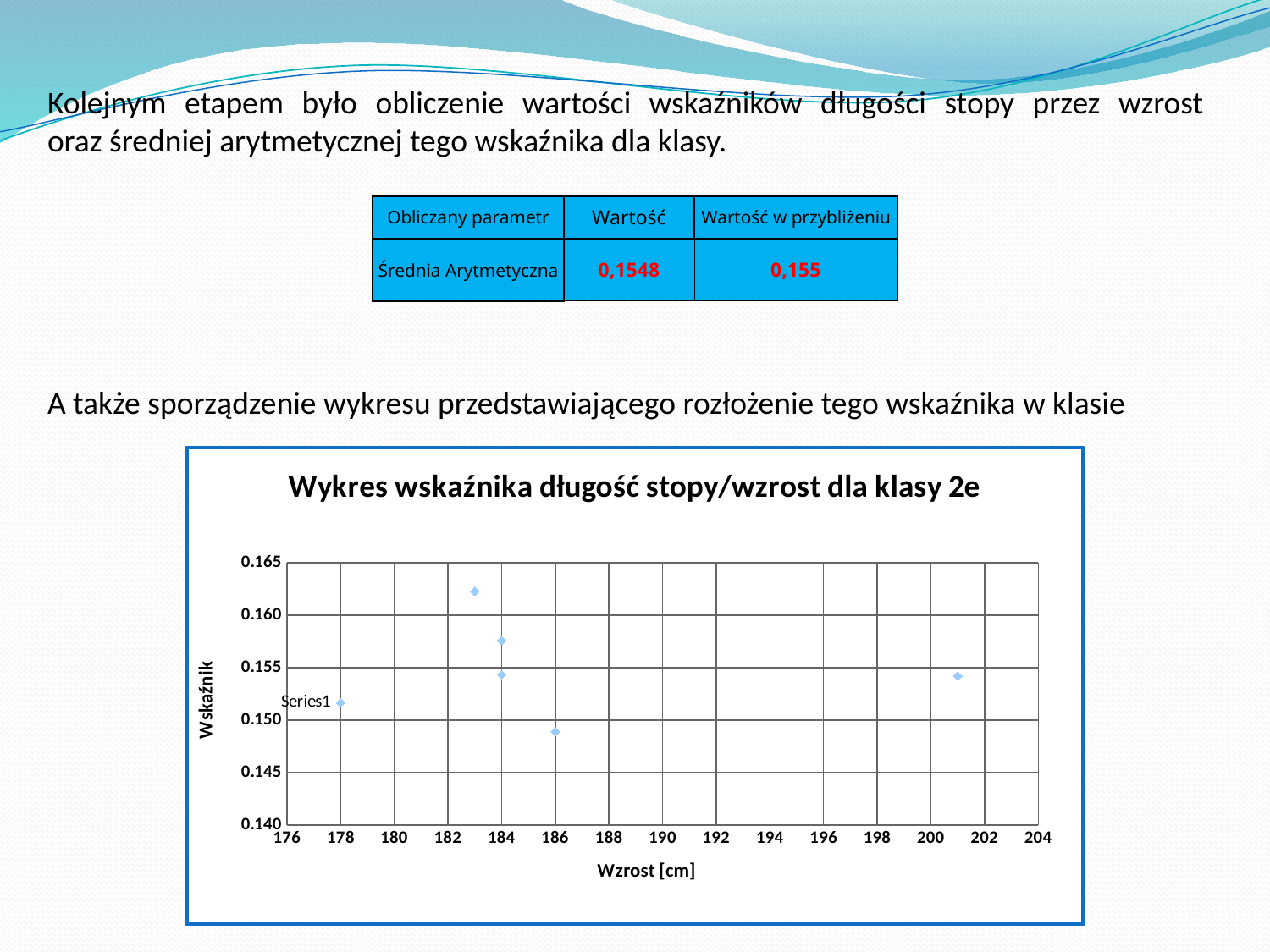
Which point has a higher Wskaźnik value: the one at 178 cm or the one at 186 cm? 178 cm What is the title of the chart? Wykres wskaźnika długość stopy/wzrost dla klasy 2e Is the Wskaźnik value for the point at 201 cm greater or less than 0.150? greater What is the label of the x axis of the chart? Wzrost [cm] Which point has a higher Wskaźnik value: the one at 183 cm or the one at 186 cm? 183 cm Is the Wskaźnik value for the point at 178 cm greater or less than 0.155? less What kind of chart is shown on the slide? scatter chart How many data points are plotted on the chart? 6 Is the Wskaźnik value for the point at 186 cm greater or less than 0.150? less At which height (Wzrost) is the lowest Wskaźnik value plotted? 186 At which height (Wzrost) is the highest Wskaźnik value plotted? 183